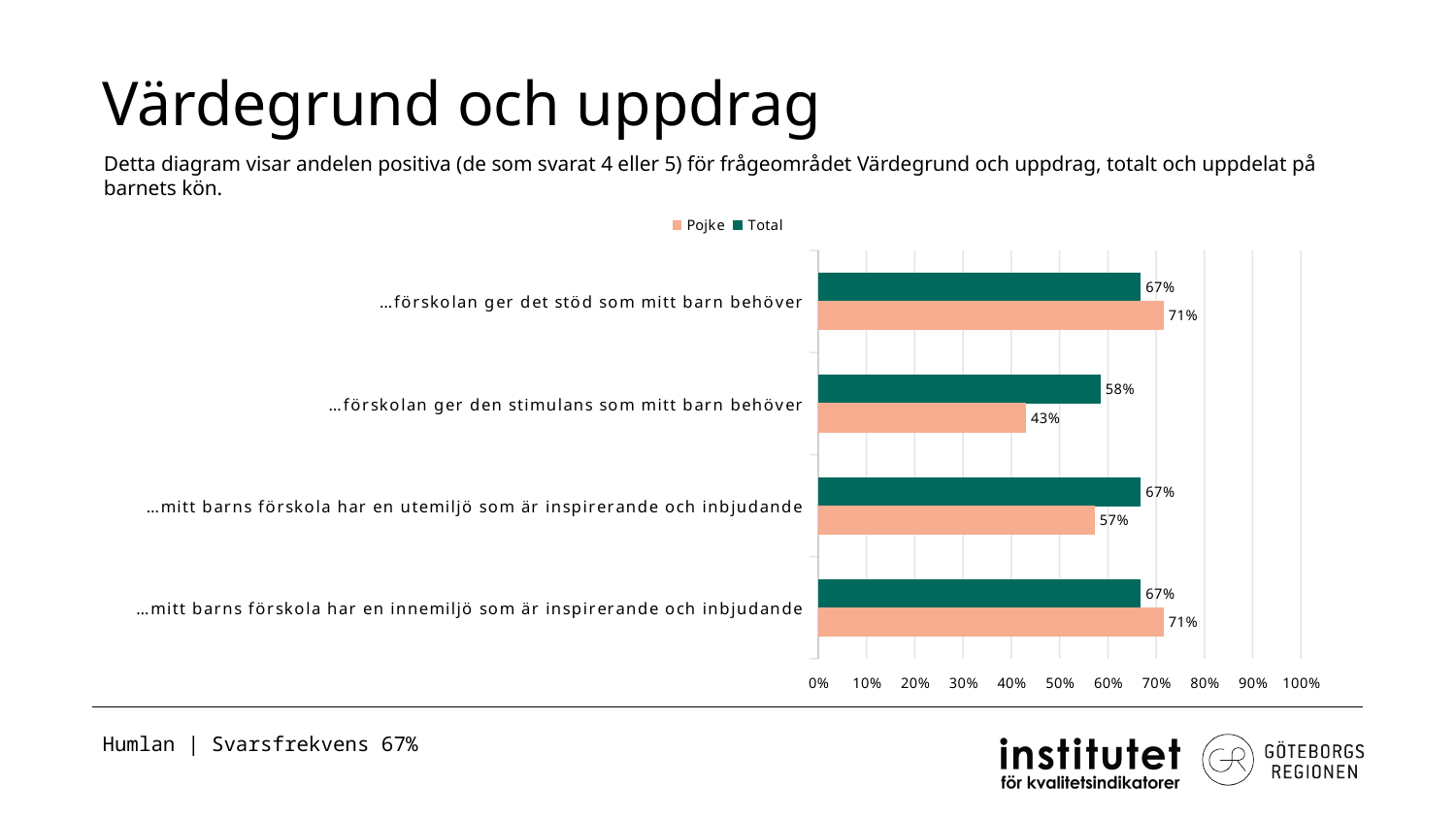
What kind of chart is shown on the slide? Bar chart How many categories are shown on the chart? 4 What is the Total value for "…förskolan ger den stimulans som mitt barn behöver"? 58% How many series does the legend list? 2 What is the difference between the Pojke and Total values for "…mitt barns förskola har en innemiljö som är inspirerande och inbjudande"? 4 percentage points What is the Pojke value for "…förskolan ger den stimulans som mitt barn behöver"? 43% What is the Pojke value for "…förskolan ger det stöd som mitt barn behöver"? 71% What is the difference between the Total and Pojke values for "…förskolan ger den stimulans som mitt barn behöver"? 15 percentage points Which category has the lowest Pojke value? …förskolan ger den stimulans som mitt barn behöver What is the Total value for "…mitt barns förskola har en utemiljö som är inspirerande och inbjudande"? 67% For "…mitt barns förskola har en utemiljö som är inspirerande och inbjudande", which is larger, the Pojke value or the Total value? Total Which category has the lowest Total value? …förskolan ger den stimulans som mitt barn behöver